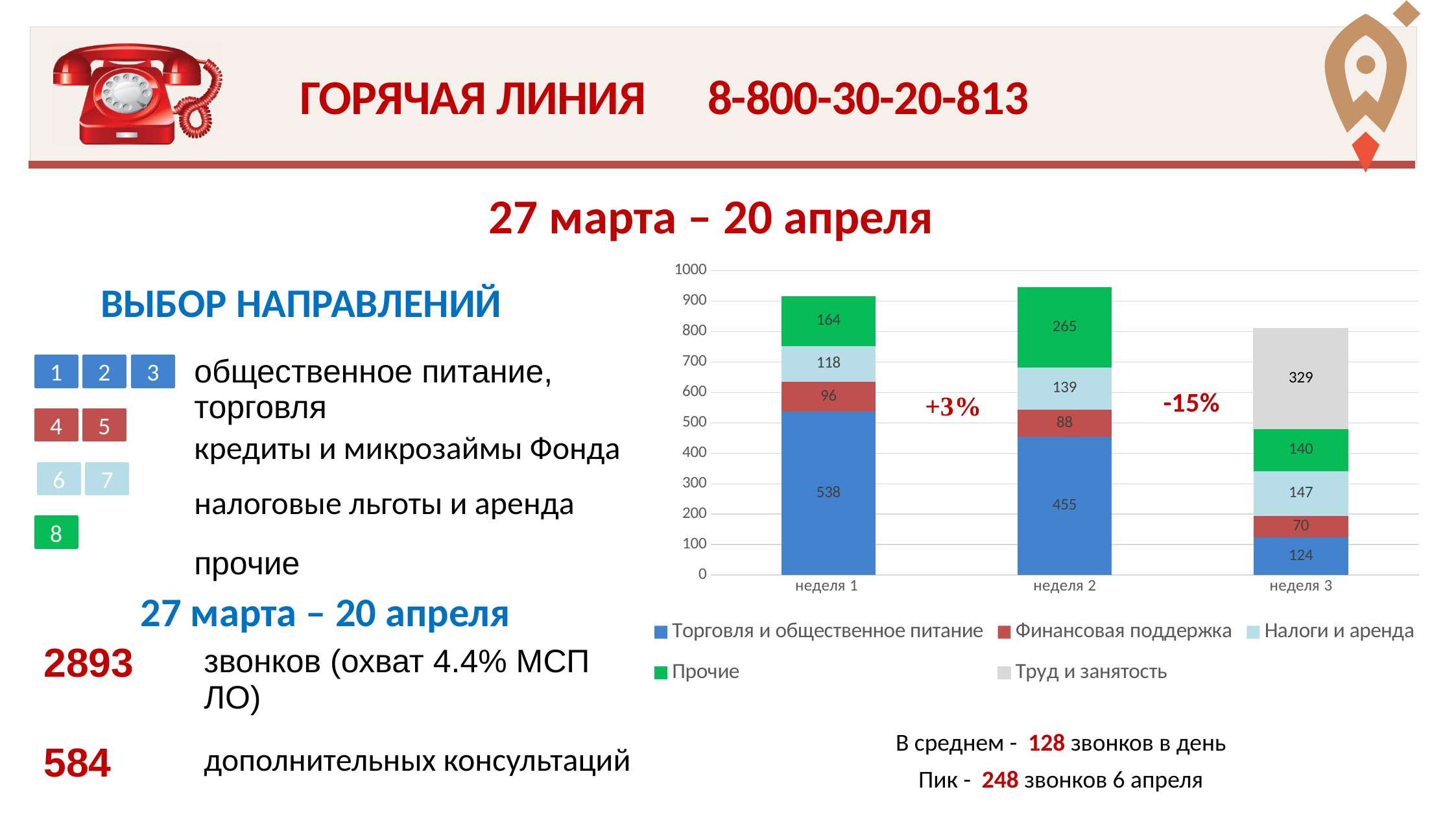
What is the value for Прочие in неделя 2? 265 What is the total of the stacked bar for неделя 1? 916 What is the value for Торговля и общественное питание in неделя 1? 538 In which week is the value for Прочие the highest? неделя 2 In which week is the value for Торговля и общественное питание the lowest? неделя 3 How many weeks (categories) are shown on the x axis of the chart? 3 What kind of chart is shown on the slide? stacked bar chart Which is larger: Налоги и аренда in неделя 2 or in неделя 3? неделя 3 How many series does the chart legend list? 5 What is the value for Труд и занятость in неделя 3? 329 What is the difference between the Торговля и общественное питание values for неделя 1 and неделя 2? 83 What is the value for Финансовая поддержка in неделя 3? 70